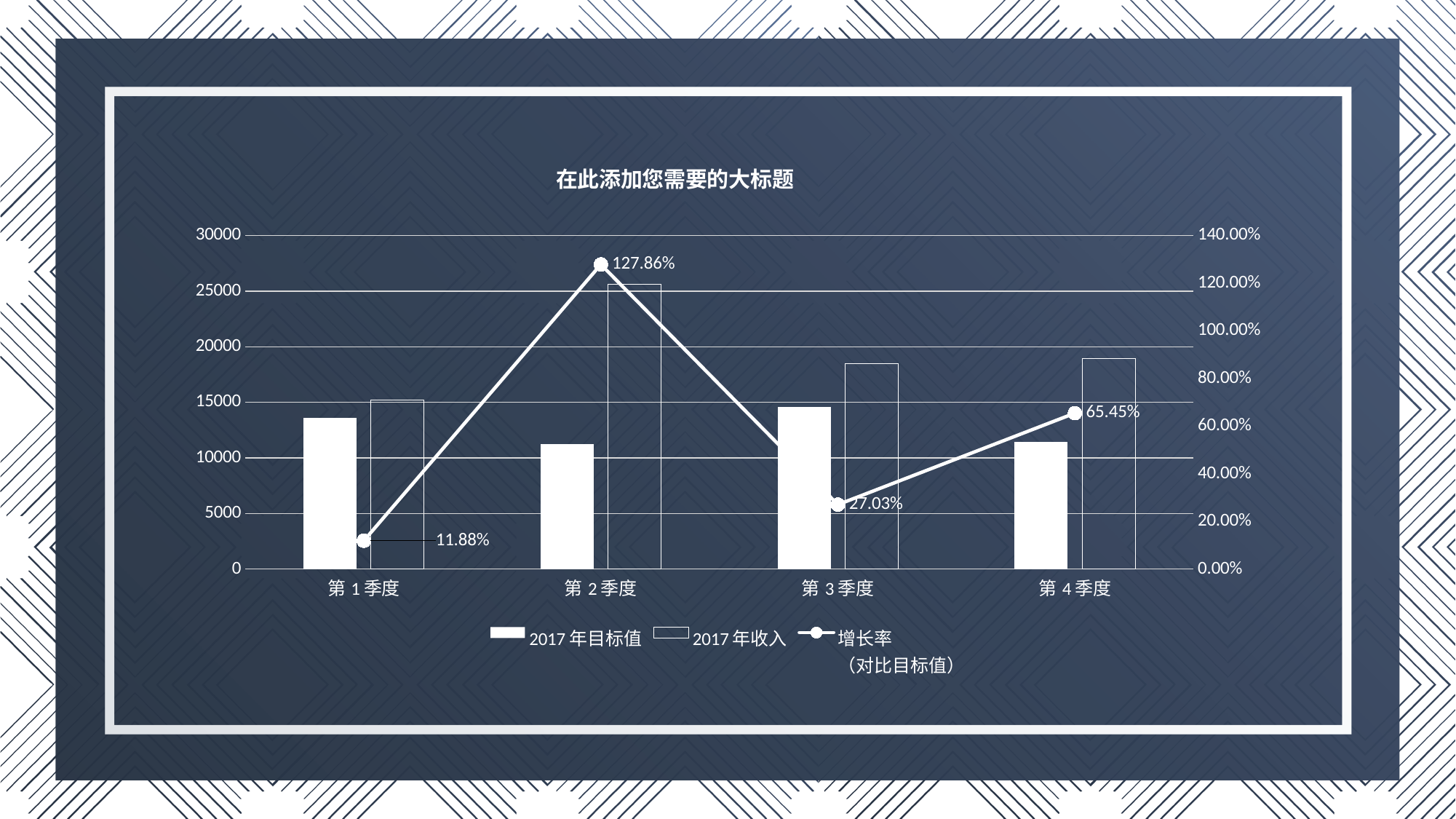
What is the growth rate (增长率) for 第 1 季度? 11.88% Is the 2017 年收入 value for 第 2 季度 greater or less than 25000? greater Which quarter has the highest growth rate (增长率)? 第 2 季度 Is the 2017 年目标值 value for 第 4 季度 greater or less than 15000? less What kind of chart is shown on the slide? Combined bar and line chart Which quarter has the lowest growth rate (增长率)? 第 1 季度 What is the growth rate (增长率) for 第 2 季度? 127.86% Which is larger, the growth rate for 第 4 季度 or 第 3 季度? 第 4 季度 How many series does the legend list? 3 How many quarters are shown on the x axis? 4 What is the growth rate (增长率) for 第 4 季度? 65.45% What is the difference between the growth rate for 第 2 季度 and 第 3 季度? 100.83%